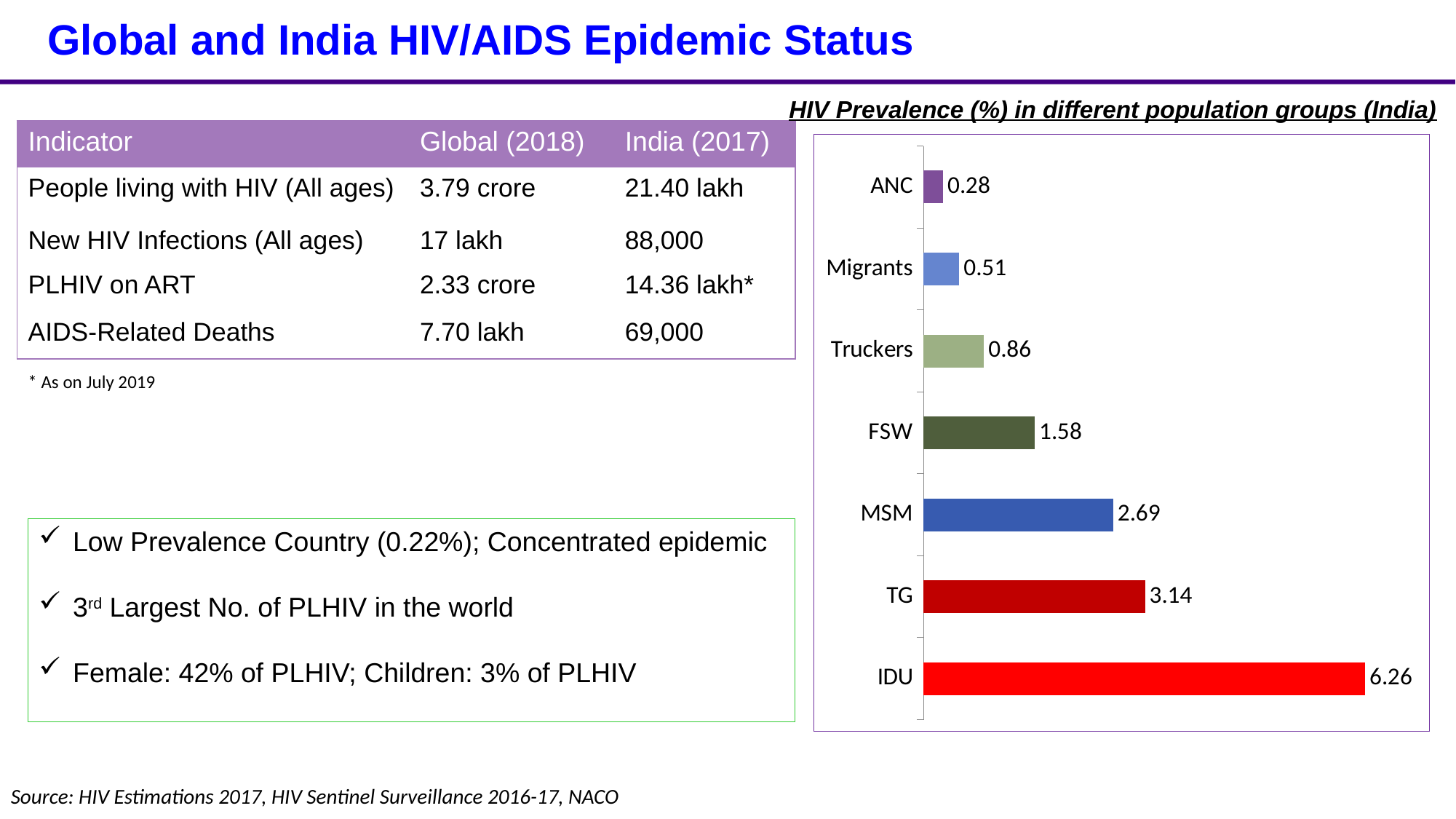
What is the HIV prevalence (%) for Truckers in the chart? 0.86 Which has a higher HIV prevalence, Migrants or Truckers? Truckers Which has a higher HIV prevalence, FSW or TG? TG How many population groups are shown in the chart? 7 Which population group has the highest HIV prevalence in the chart? IDU What type of chart is used to show HIV prevalence in different population groups? Bar chart Which population group has the lowest HIV prevalence in the chart? ANC What is the difference in HIV prevalence (%) between IDU and FSW? 4.68 What is the title of the chart on the slide? HIV Prevalence (%) in different population groups (India) What is the HIV prevalence (%) for IDU in the chart? 6.26 What is the difference in HIV prevalence (%) between TG and MSM? 0.45 What is the HIV prevalence (%) for MSM in the chart? 2.69